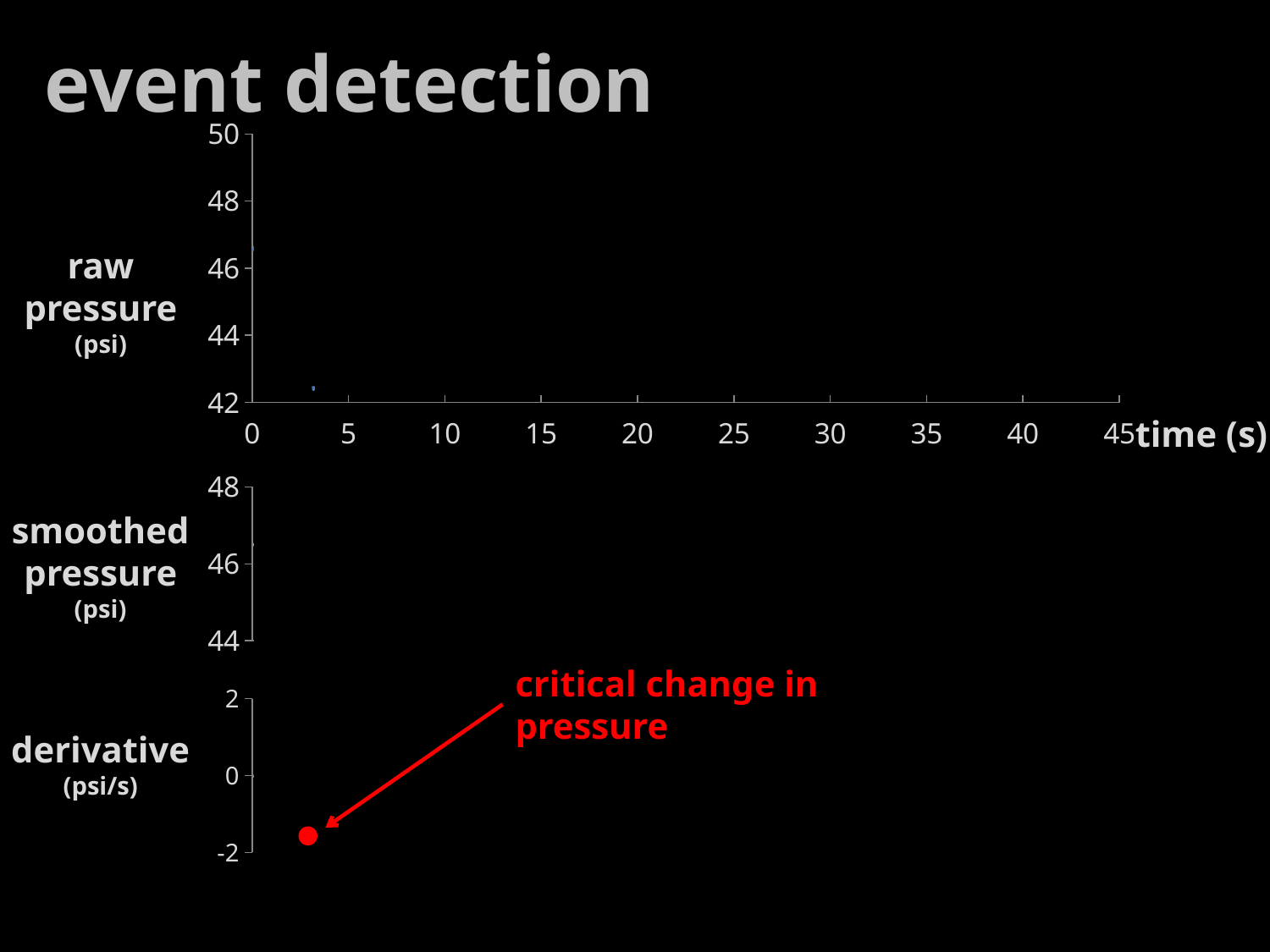
In the derivative chart, is the value of the red marked point greater or less than -2? greater What is the label of the shared x axis shown under the raw pressure chart? time (s) What does the red annotation pointing to the marked point in the derivative chart say? critical change in pressure In the derivative chart, is the value of the red marked point greater or less than 0? less In the derivative chart, is the value of the red marked point greater or less than 2? less